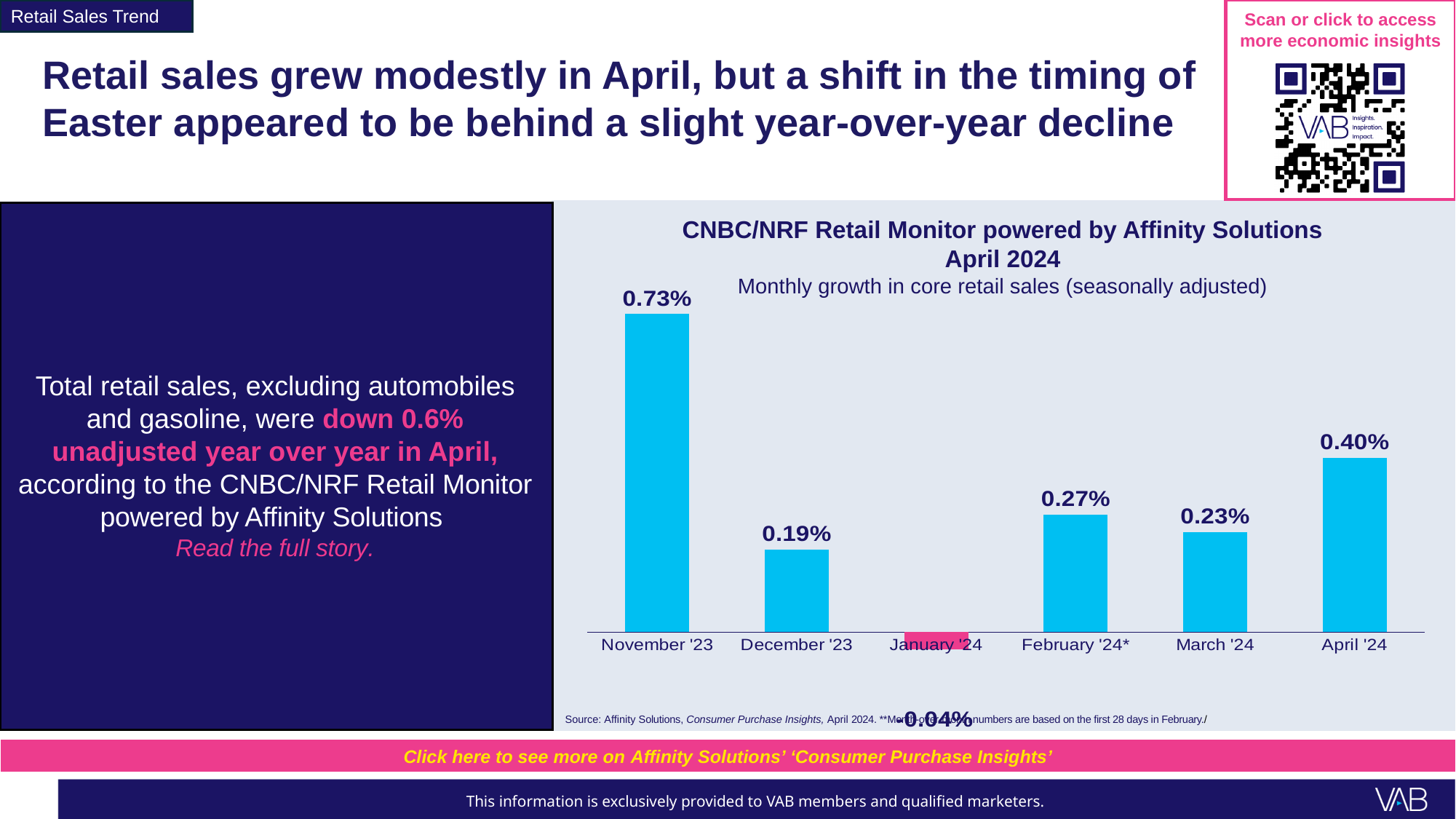
What is the monthly growth in core retail sales for November '23? 0.73% What value is shown for March '24? 0.23% Which is larger, the value for February '24* or the value for March '24? February '24* How much higher is the value for November '23 than the value for April '24? 0.33% From March '24 to April '24, does the monthly growth value rise or fall? Rise What is the monthly growth in core retail sales for April '24? 0.40% How many months are shown on the chart? 6 Which month has the lowest monthly growth in core retail sales? January '24 What kind of chart is used to show monthly growth in core retail sales? Bar chart Which month has the highest monthly growth in core retail sales? November '23 What value is shown for December '23? 0.19% What value is shown for February '24*? 0.27%